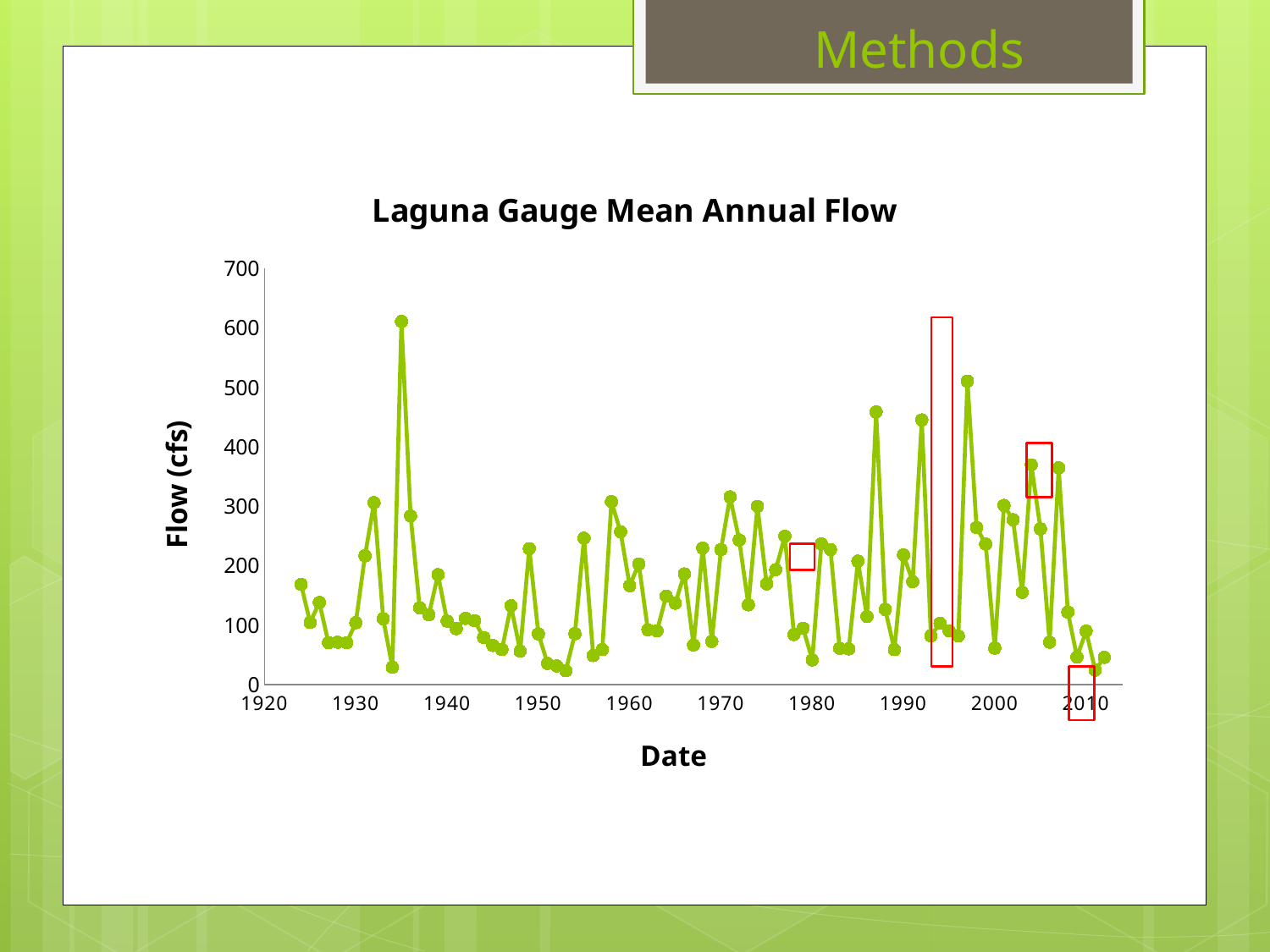
Which year has the larger flow value, 1987 or 1953? 1987 In which year does the chart show the highest mean annual flow? 1935 Is the flow value for 1987 greater or less than 400? greater Which year has the larger flow value, 1935 or 1997? 1935 Is the flow value for 1924 greater or less than 200? less Do the flow values rise or fall from 2007 to 2011? fall Is the flow value for 1935 greater or less than 500? greater What is the label of the vertical axis? Flow (cfs) What kind of chart is shown on the slide? line chart What is the title of the chart? Laguna Gauge Mean Annual Flow